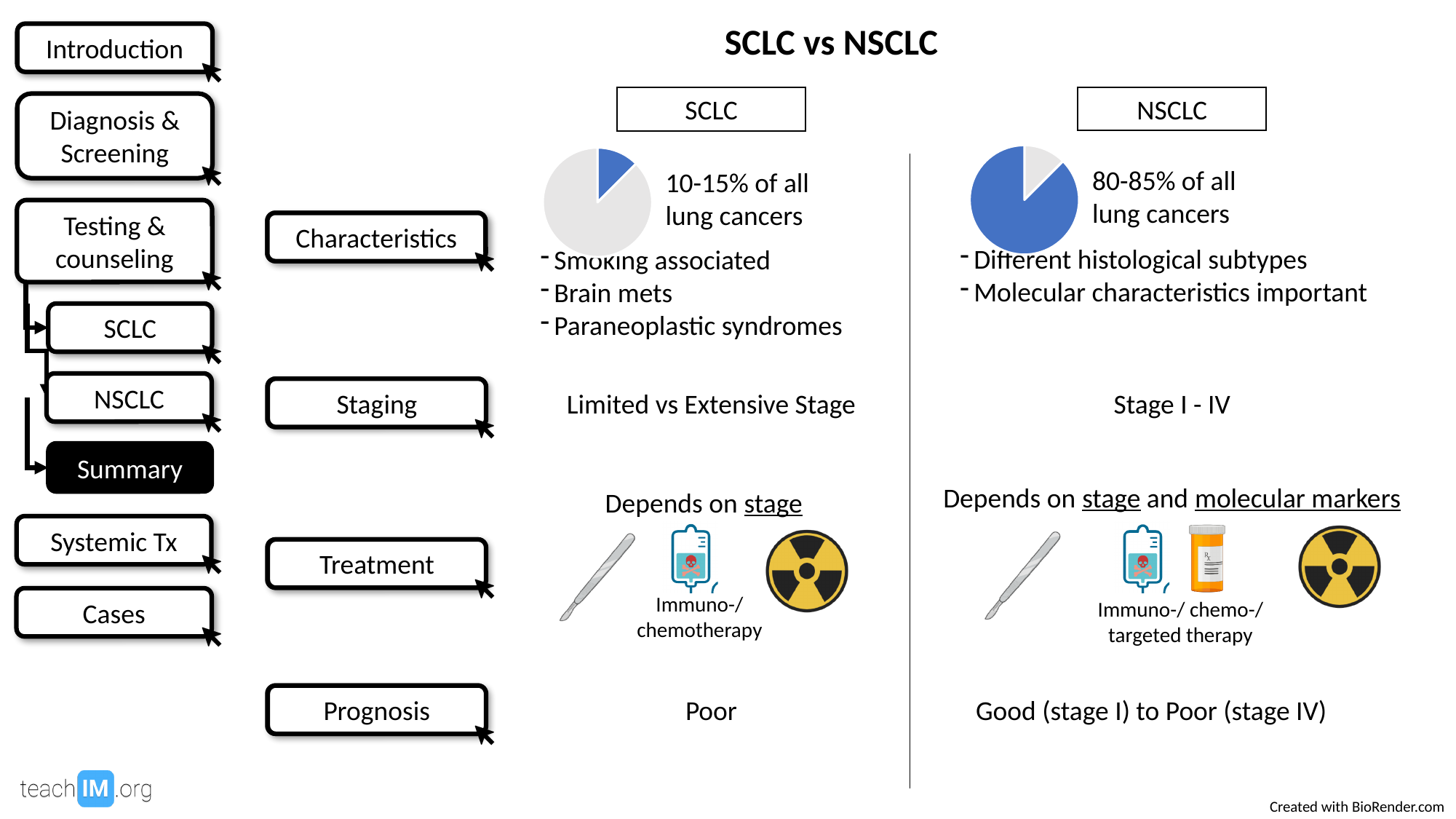
What kind of chart is used to show the share of all lung cancers for SCLC and NSCLC? Pie chart What colour is the highlighted slice in both pie charts? Blue According to the NSCLC pie chart, what share of all lung cancers is NSCLC? 80-85% Which lung cancer type has the smaller share of all lung cancers according to the pie charts? SCLC Is the highlighted share in the NSCLC pie chart greater or less than 50%? greater How many pie charts are shown on the slide? 2 Is the highlighted share in the SCLC pie chart greater or less than 50%? less What is the title of the slide containing the two pie charts? SCLC vs NSCLC Which lung cancer type has the larger share of all lung cancers according to the pie charts? NSCLC Which pie chart shows the larger highlighted share of all lung cancers, SCLC or NSCLC? NSCLC According to the SCLC pie chart, what share of all lung cancers is SCLC? 10-15%